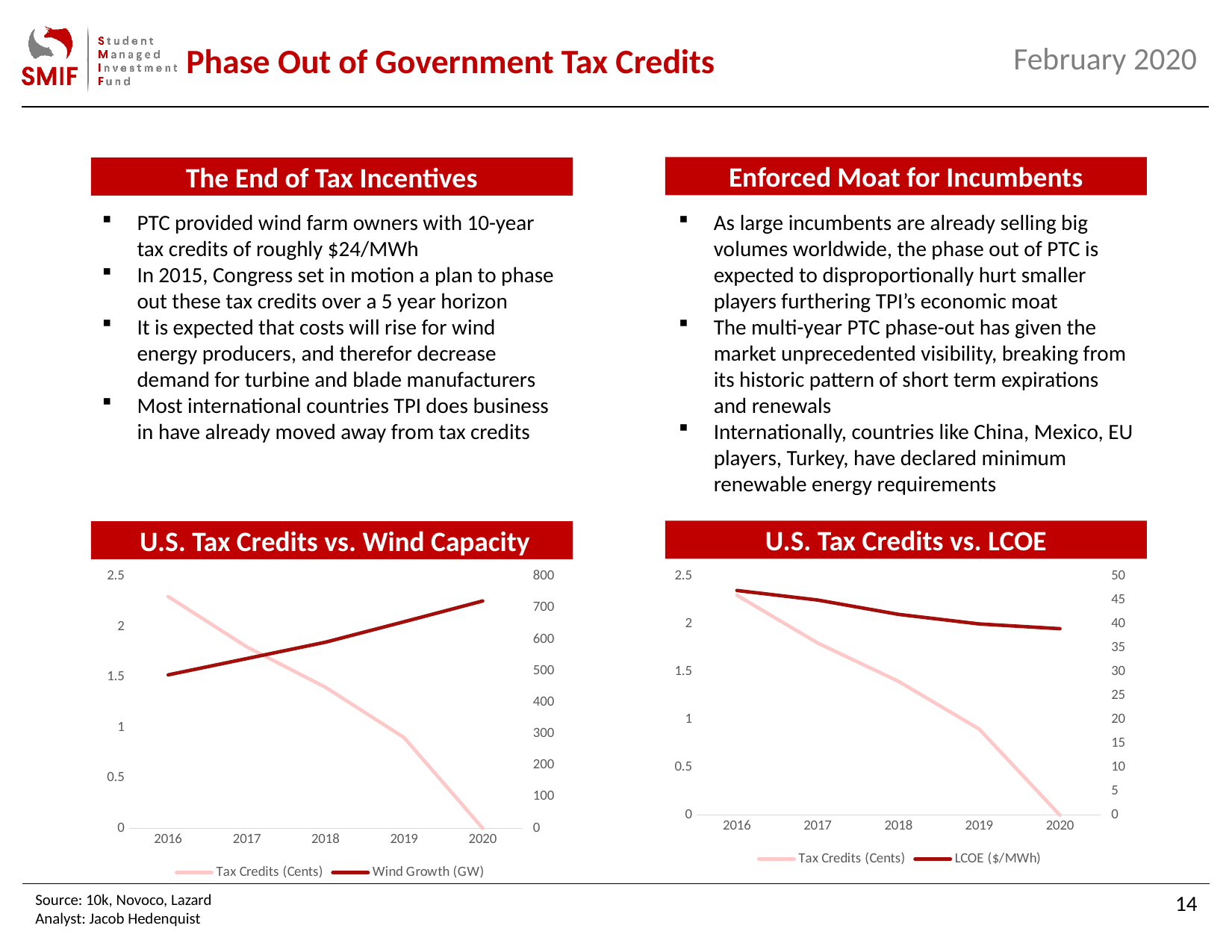
In the 'U.S. Tax Credits vs. Wind Capacity' chart, does the Wind Growth (GW) series rise or fall from 2016 to 2020? Rise In the 'U.S. Tax Credits vs. LCOE' chart, does the LCOE ($/MWh) series rise or fall over the period shown? Fall In the 'U.S. Tax Credits vs. LCOE' chart, is the LCOE ($/MWh) value for 2020 greater or less than 35? greater In the 'U.S. Tax Credits vs. LCOE' chart, which year has the highest Tax Credits (Cents) value? 2016 In the 'U.S. Tax Credits vs. Wind Capacity' chart, is the Wind Growth (GW) value for 2020 greater or less than 600? greater In the 'U.S. Tax Credits vs. Wind Capacity' chart, which year has the lowest Wind Growth (GW) value? 2016 What are the two series listed in the legend of the 'U.S. Tax Credits vs. Wind Capacity' chart? Tax Credits (Cents) and Wind Growth (GW) In the 'U.S. Tax Credits vs. LCOE' chart, does the Tax Credits (Cents) series rise or fall from 2016 to 2020? Fall What type of chart is the 'U.S. Tax Credits vs. Wind Capacity' chart? Line chart In the 'U.S. Tax Credits vs. Wind Capacity' chart, is the Tax Credits (Cents) value for 2016 greater or less than 2? greater How many years are shown on the x axis of the 'U.S. Tax Credits vs. Wind Capacity' chart? 5 How many series does the legend of the 'U.S. Tax Credits vs. LCOE' chart list? 2